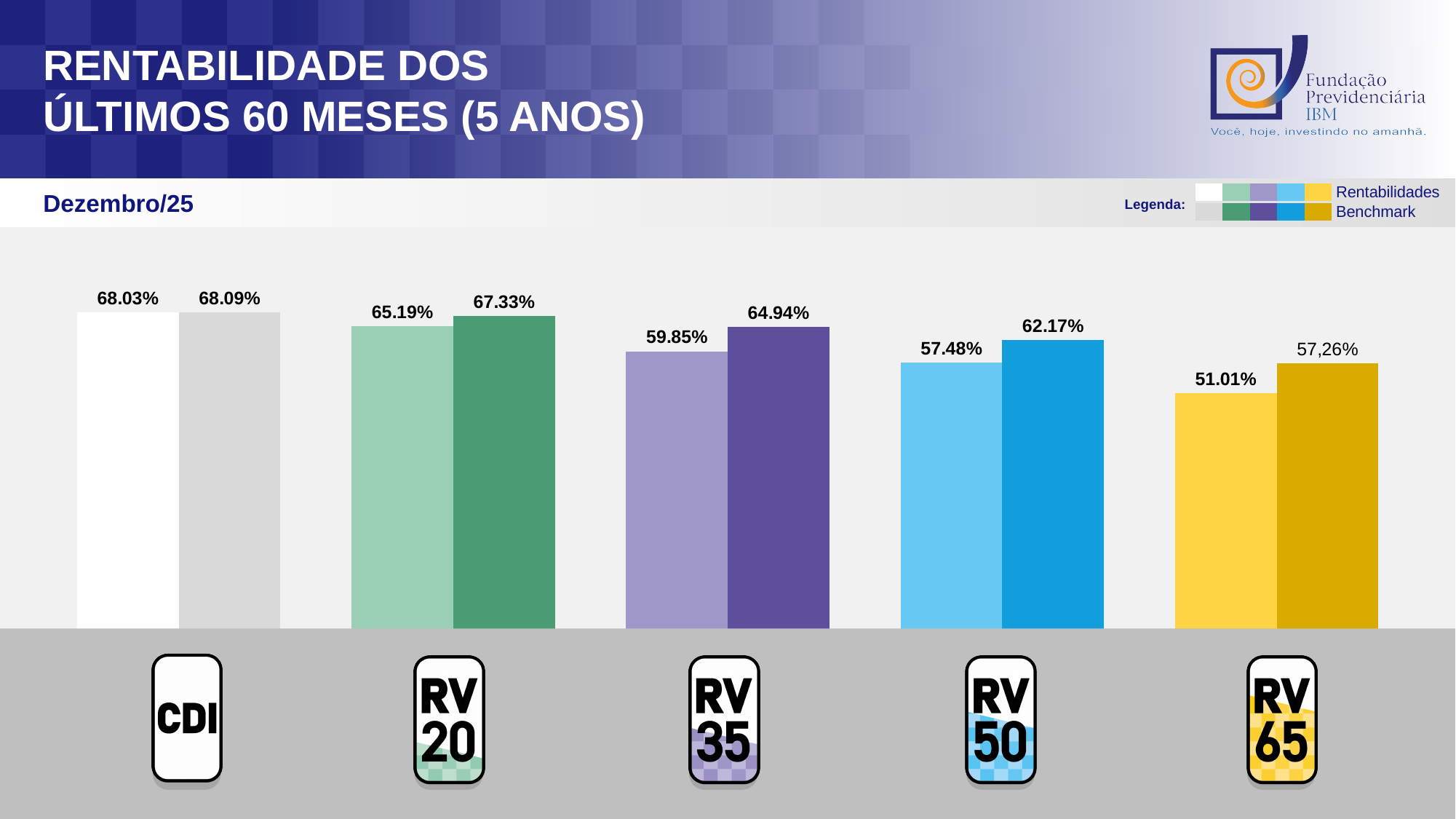
What is the Rentabilidades value for RV 65? 51.01% Which category has the highest Rentabilidades value? CDI How many series does the legend list? 2 How many categories are shown on the chart? 5 What is the difference between the Benchmark and Rentabilidades values for RV 20? 2.14% What is the Benchmark value for RV 35? 64.94% Which category has the lowest Benchmark value? RV 65 Which is larger for RV 50, the Rentabilidades value or the Benchmark value? Benchmark Do the Rentabilidades values rise or fall from CDI to RV 65? fall What is the difference between the Benchmark and Rentabilidades values for RV 35? 5.09% What is the Rentabilidades value for RV 20? 65.19% What is the Benchmark value for RV 50? 62.17%